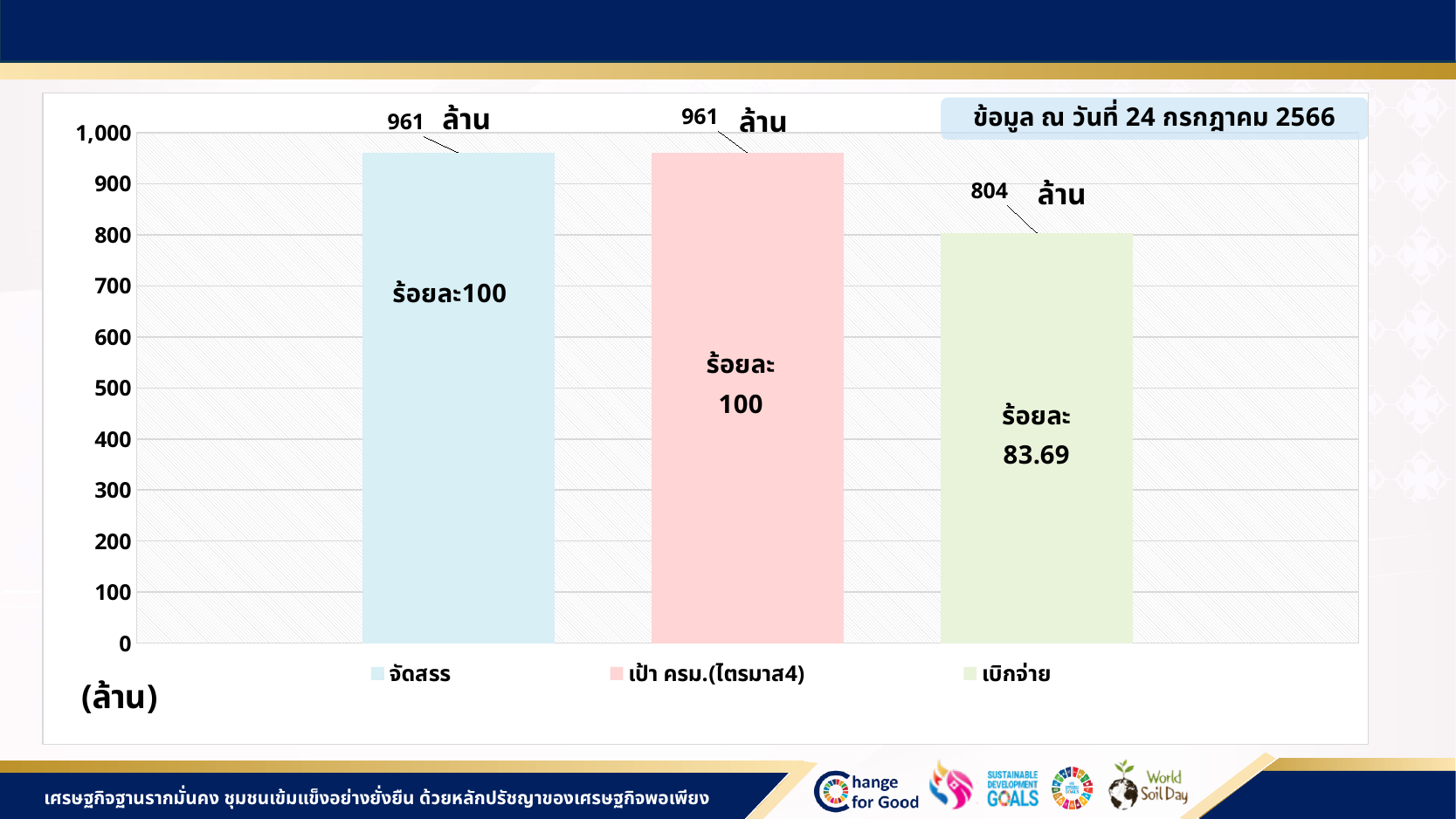
How many bars are plotted in the chart? 3 How many entries does the legend list? 3 What is the difference between the values for จัดสรร and เบิกจ่าย? 157 What is the value for เป้า ครม.(ไตรมาส4)? 961 What date is the data on the chart stated to be as of? 24 กรกฎาคม 2566 Which bar is the lowest? เบิกจ่าย Which is larger, the value for เป้า ครม.(ไตรมาส4) or the value for เบิกจ่าย? เป้า ครม.(ไตรมาส4) What is the value for เบิกจ่าย? 804 What is the value for จัดสรร? 961 What percentage is printed inside the เบิกจ่าย bar? ร้อยละ 83.69 Is the value for เบิกจ่าย greater or less than 900? less What kind of chart is shown on the slide? bar chart